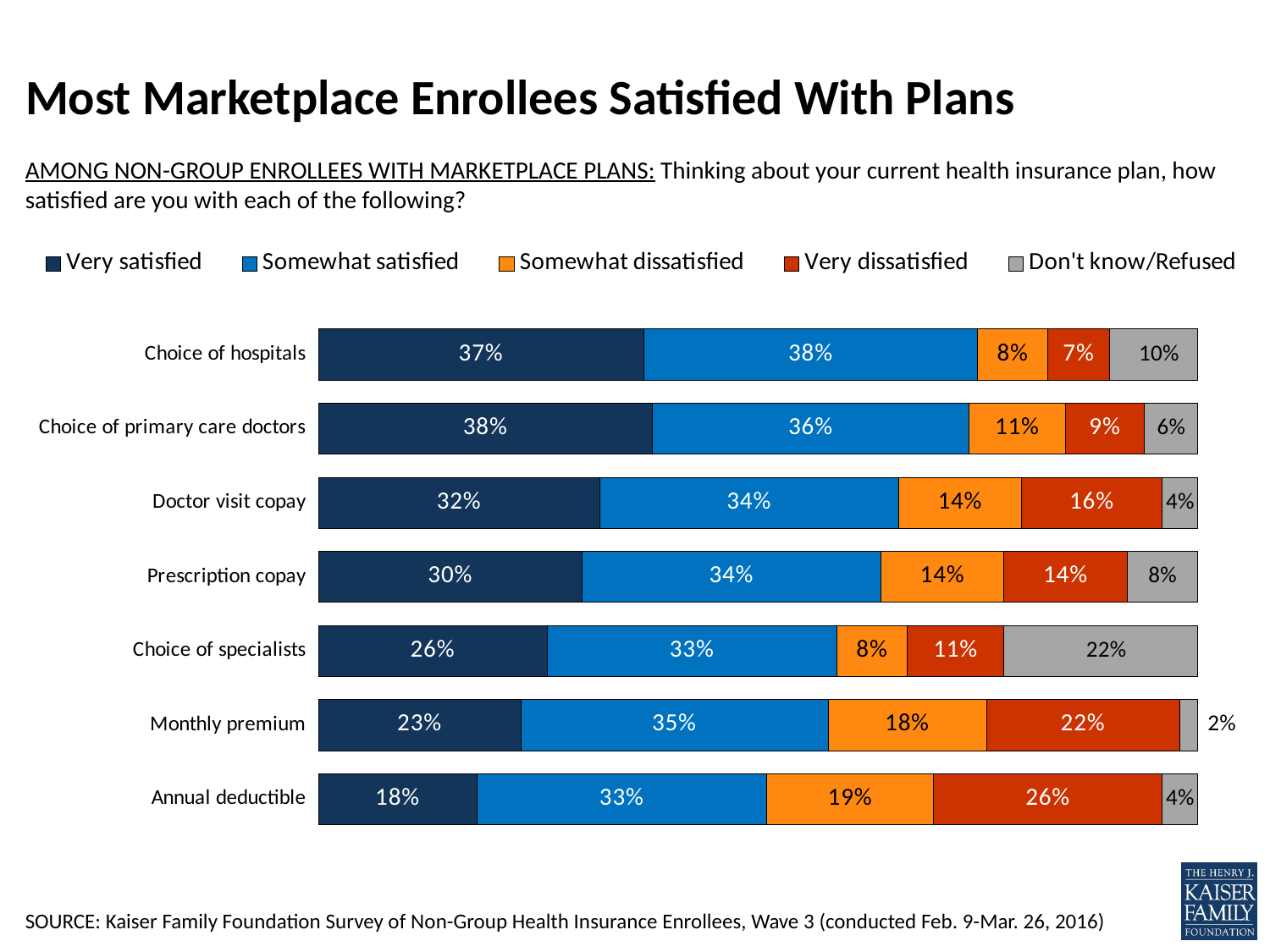
What percentage of enrollees are somewhat dissatisfied with their monthly premium? 18% Which item has the highest share of very satisfied enrollees? Choice of primary care doctors What percentage of enrollees are very satisfied with their choice of hospitals? 37% What percentage of enrollees answered Don't know/Refused for choice of specialists? 22% How many series does the legend list? 5 Which is larger: the somewhat satisfied share for choice of hospitals or for choice of specialists? Choice of hospitals What is the difference between the very dissatisfied share for annual deductible and for choice of hospitals? 19 percentage points Which item has the lowest share of very satisfied enrollees? Annual deductible What kind of chart is shown on the slide? Stacked bar chart How many items are listed on the chart? 7 What is the combined share of very satisfied and somewhat satisfied enrollees for doctor visit copay? 66% What percentage of enrollees are very dissatisfied with their annual deductible? 26%